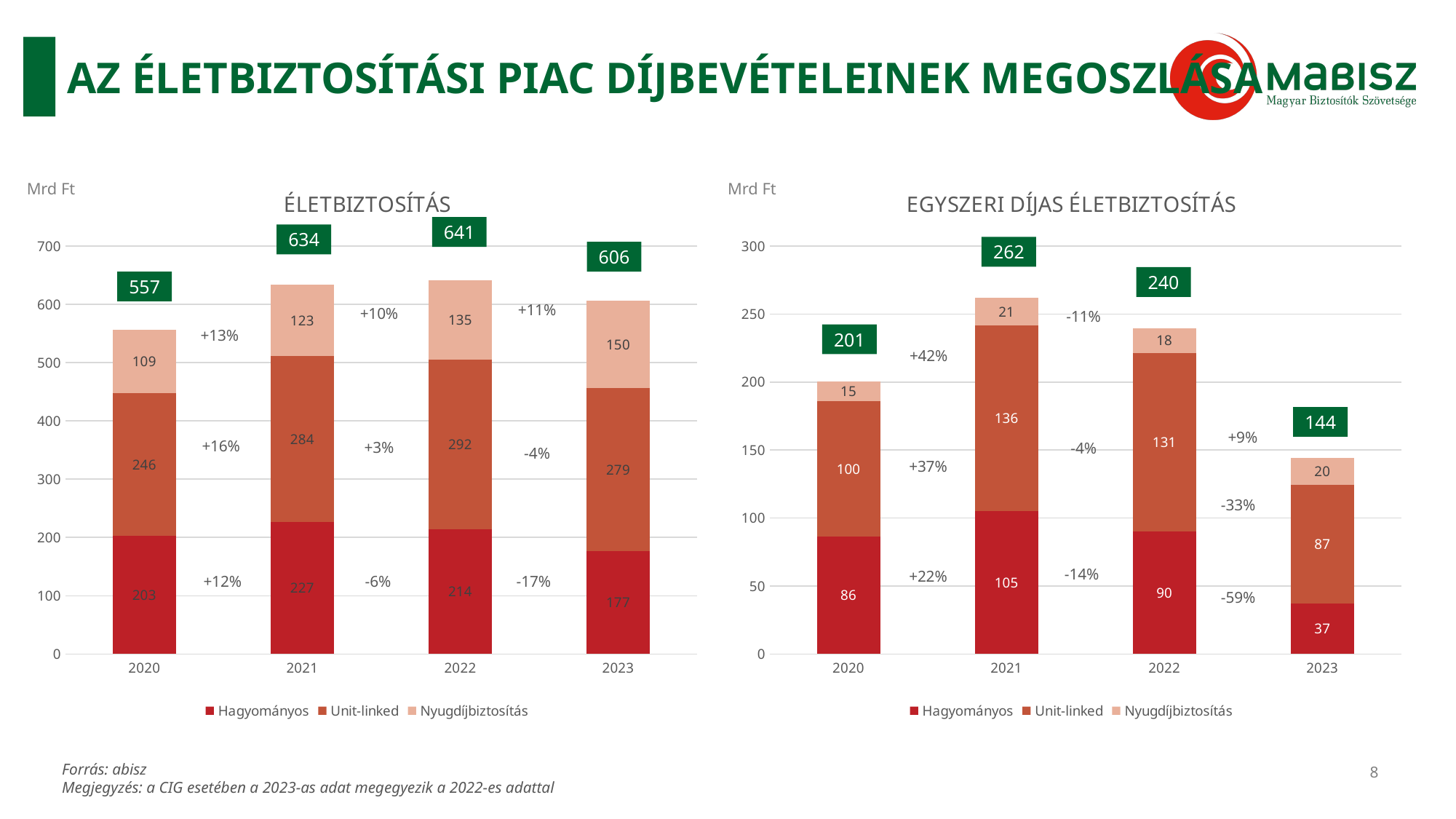
In the EGYSZERI DÍJAS ÉLETBIZTOSÍTÁS chart, is the Hagyományos value for 2020 larger or smaller than the Hagyományos value for 2022? smaller In the ÉLETBIZTOSÍTÁS chart, what is the Nyugdíjbiztosítás value for 2023? 150 In the EGYSZERI DÍJAS ÉLETBIZTOSÍTÁS chart, what is the Unit-linked value for 2021? 136 How many series does the legend of the ÉLETBIZTOSÍTÁS chart list? 3 In the ÉLETBIZTOSÍTÁS chart, which year has the lowest total? 2020 In the EGYSZERI DÍJAS ÉLETBIZTOSÍTÁS chart, which year has the highest total? 2021 What kind of chart is the ÉLETBIZTOSÍTÁS chart? stacked bar chart How many years are shown on the x axis of the EGYSZERI DÍJAS ÉLETBIZTOSÍTÁS chart? 4 In the EGYSZERI DÍJAS ÉLETBIZTOSÍTÁS chart, what is the total of the stacked bar for 2023? 144 In the ÉLETBIZTOSÍTÁS chart, what is the difference between the Unit-linked values for 2022 and 2023? 13 In the ÉLETBIZTOSÍTÁS chart, what is the Hagyományos value for 2020? 203 In the ÉLETBIZTOSÍTÁS chart, what is the total of the stacked bar for 2022? 641